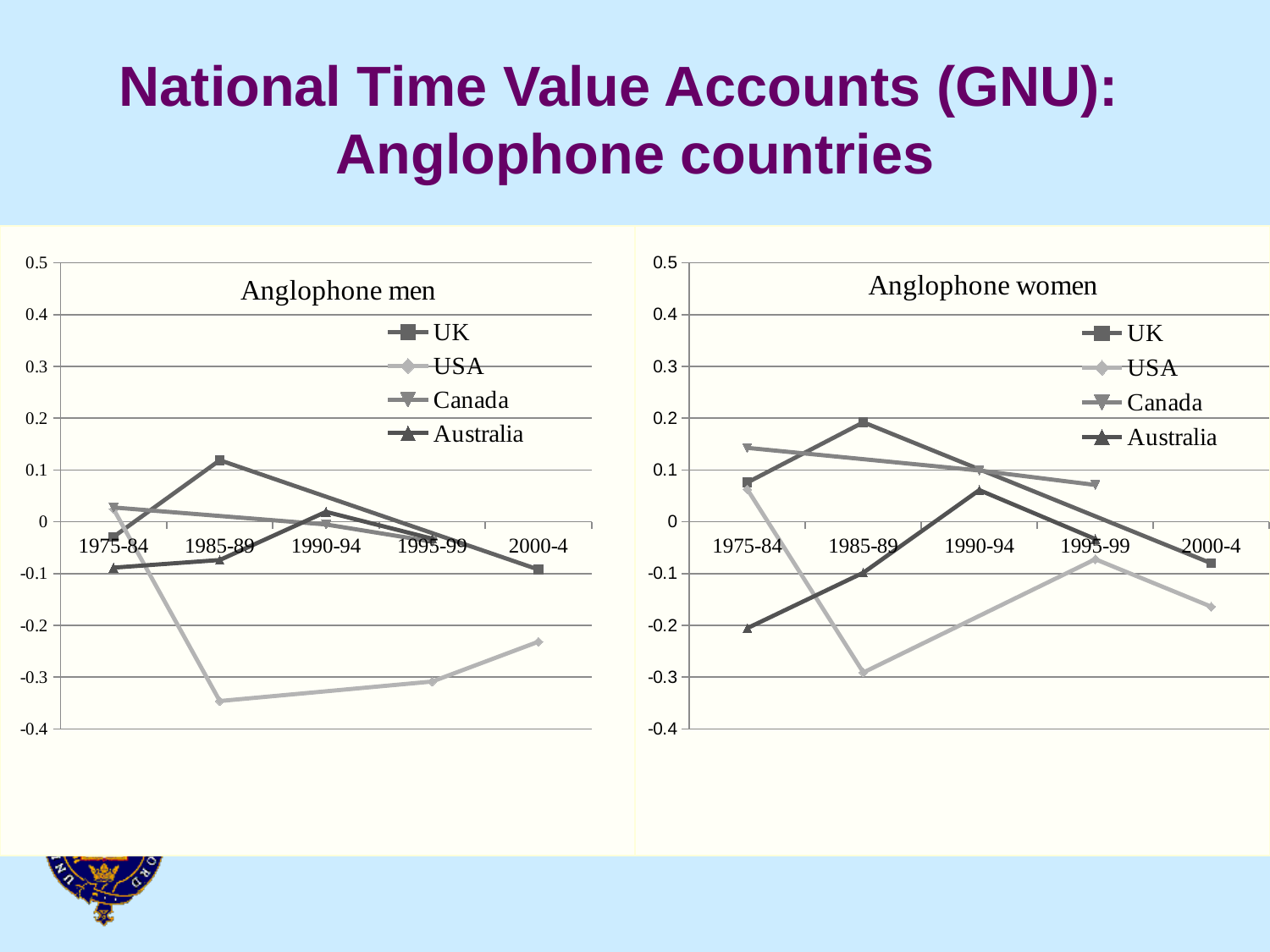
In the 'Anglophone men' chart, which is larger at 1985-89: the UK value or the USA value? UK In the 'Anglophone women' chart, is the UK value for 1985-89 greater or less than 0.1? greater What kind of chart is the 'Anglophone men' chart? line chart In the 'Anglophone men' chart, does the USA line rise or fall from 1985-89 to 2000-4? rise In the 'Anglophone women' chart, which is larger at 1975-84: the Canada value or the Australia value? Canada In the 'Anglophone men' chart, is the USA value for 1985-89 greater or less than -0.3? less In the 'Anglophone men' chart, which series reaches the highest value on the chart? UK Which countries are listed in the legend of the 'Anglophone men' chart? UK, USA, Canada, Australia In the 'Anglophone women' chart, which series has the lowest value at 1985-89? USA How many time periods are shown on the x axis of the 'Anglophone men' chart? 5 In the 'Anglophone women' chart, is the Australia value for 1975-84 greater or less than -0.1? less How many series does the legend of the 'Anglophone women' chart list? 4